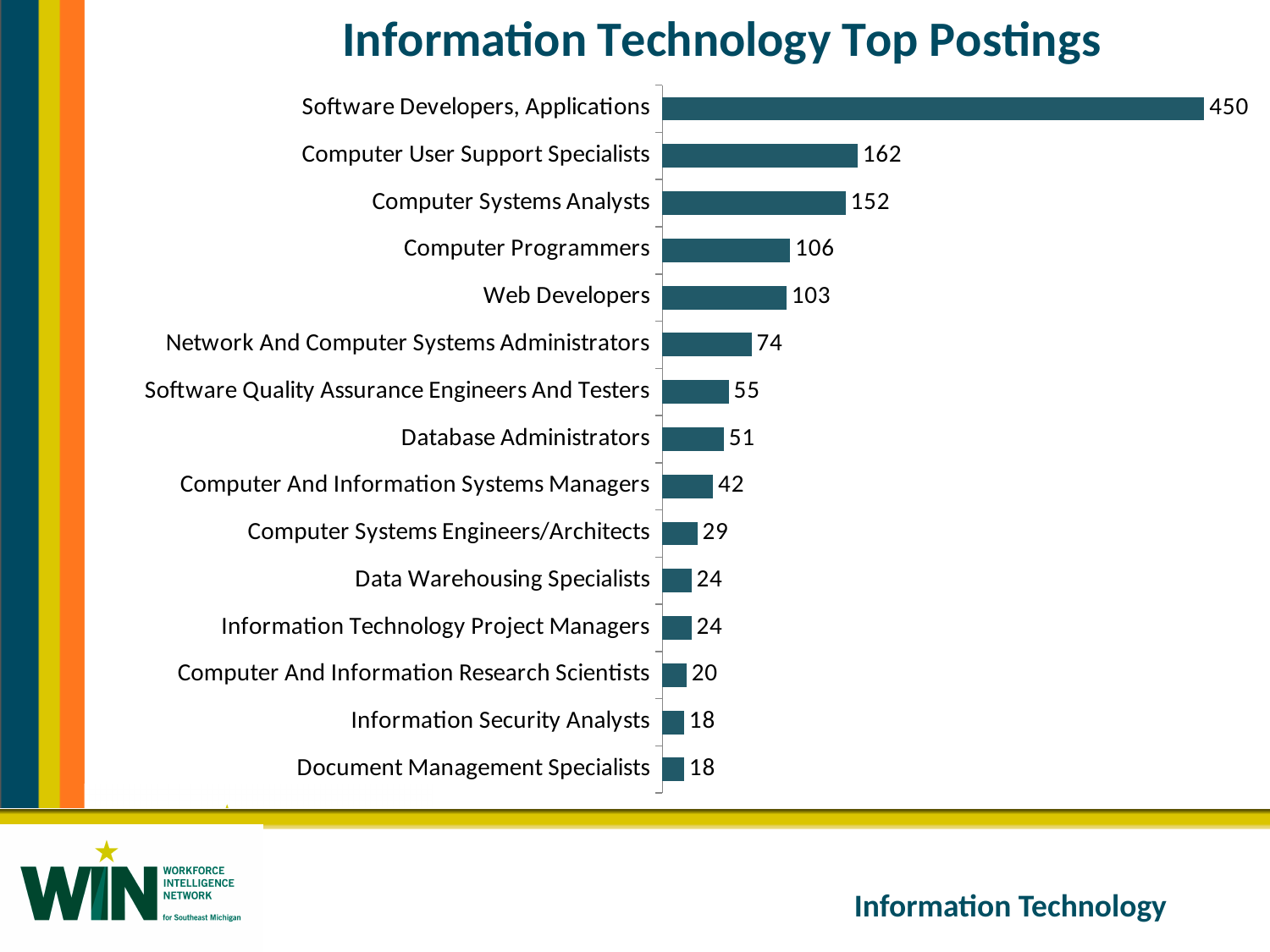
Which category has the highest number of postings? Software Developers, Applications What is the difference between the values for Computer User Support Specialists and Computer Systems Analysts? 10 Which is larger, the value for Web Developers or the value for Computer Programmers? Computer Programmers What is the value for Network And Computer Systems Administrators? 74 How many categories are shown in the chart? 15 Which category has the fewest postings, Computer Systems Engineers/Architects or Data Warehousing Specialists? Data Warehousing Specialists What is the difference between the values for Software Developers, Applications and Computer Programmers? 344 Which two categories share the lowest value of 18? Information Security Analysts and Document Management Specialists What is the title of the chart? Information Technology Top Postings What kind of chart is shown on the slide? Bar chart What is the value for Computer Systems Analysts? 152 How many postings are shown for Software Developers, Applications? 450